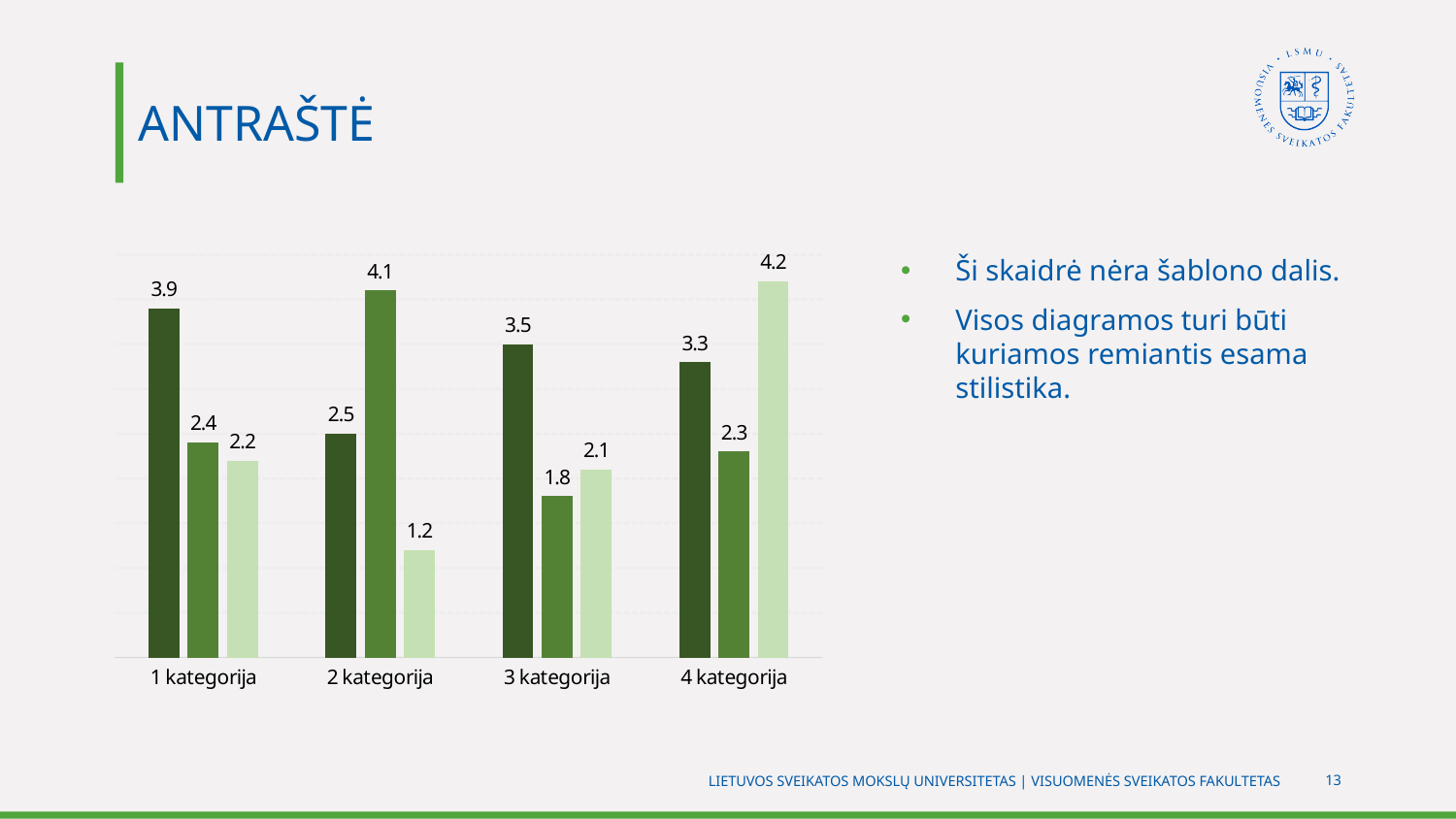
How many categories are shown on the x axis? 4 Which has the larger dark green bar, 1 kategorija or 2 kategorija? 1 kategorija What is the lowest value shown in the chart? 1.2 What is the value of the medium green bar for 3 kategorija? 1.8 What is the value of the light green bar for 2 kategorija? 1.2 What is the value of the dark green bar for 1 kategorija? 3.9 What is the value of the light green bar for 4 kategorija? 4.2 What is the value of the medium green bar for 2 kategorija? 4.1 What is the difference between the dark green bar and the medium green bar for 1 kategorija? 1.5 Which category contains the tallest bar in the chart? 4 kategorija What kind of chart is shown on the slide? Bar chart What is the difference between the light green bar and the dark green bar for 4 kategorija? 0.9